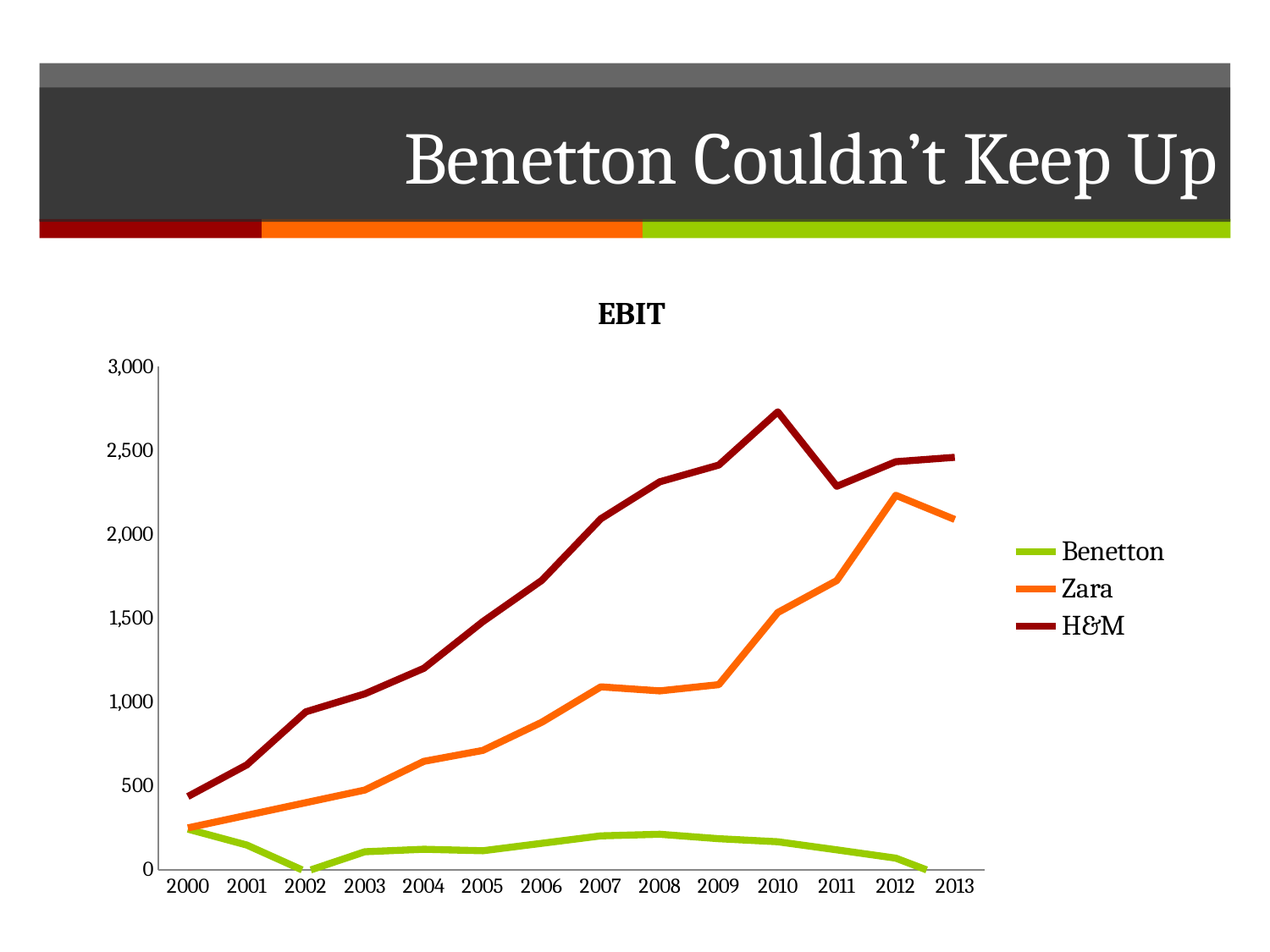
Which series is drawn in dark red in the EBIT chart? H&M What is the title of the chart? EBIT Does the Benetton line rise or fall from 2008 to 2013? fall Is the value for Zara in 2012 greater or less than 2,000? greater Is the value for H&M in 2010 greater or less than 2,500? greater How many series does the legend of the EBIT chart list? 3 In which year does the H&M line reach its highest point? 2010 What kind of chart is shown on the slide? line chart Is the value for Benetton in 2008 greater or less than 500? less Which series has the lowest EBIT in 2010? Benetton How many years are shown along the x axis of the EBIT chart? 14 Which series has the highest EBIT in 2013? H&M